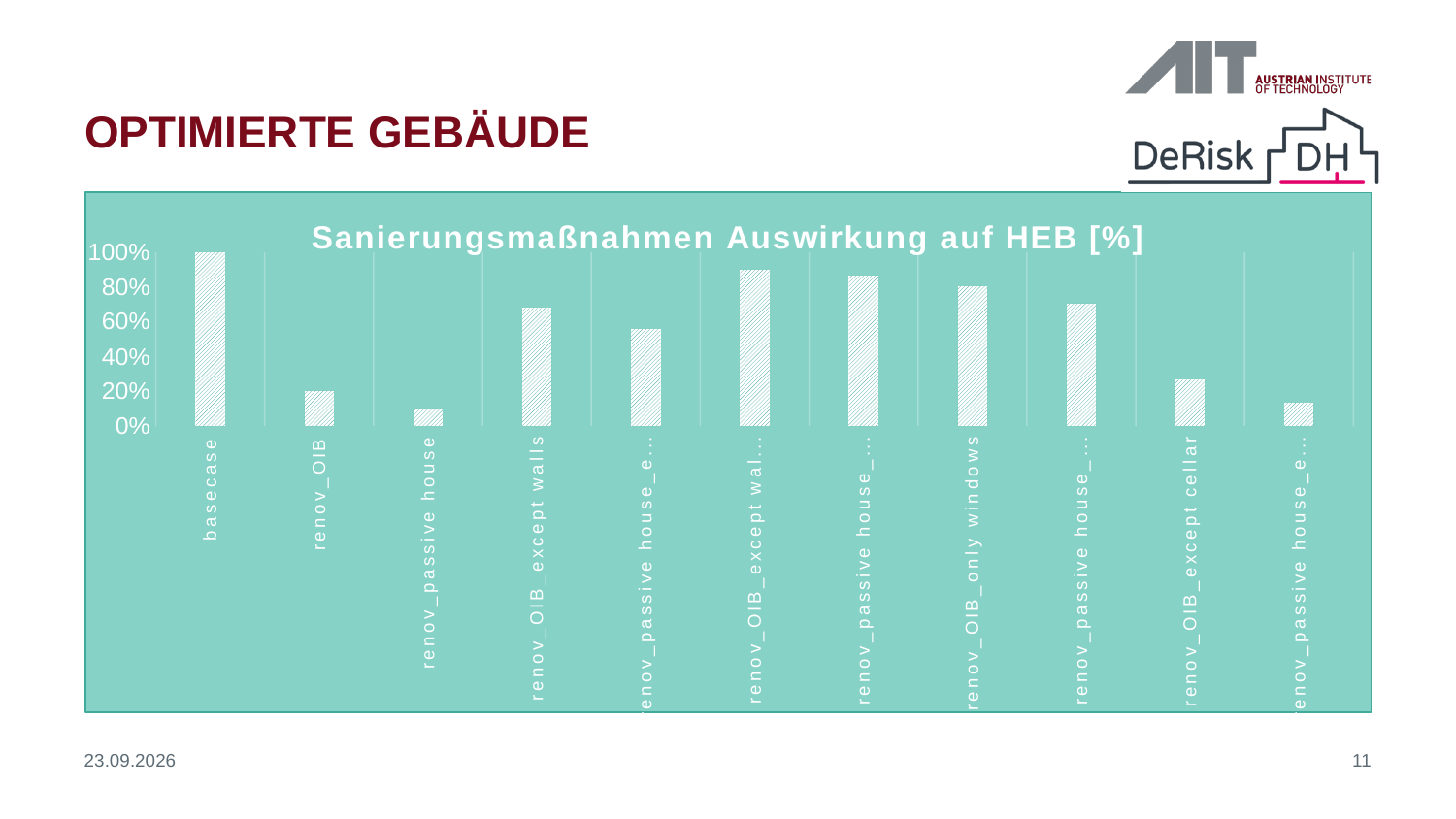
What kind of chart is shown on the slide? bar chart Which is larger, the value for renov_OIB_except walls or the value for renov_OIB_only windows? renov_OIB_only windows What is the value for basecase? 100% Is the value for renov_OIB_except walls greater or less than 60%? greater How many bars are plotted in the chart? 11 Which category has the highest value? basecase Which is larger, the value for renov_OIB or the value for renov_passive house? renov_OIB Is the value for renov_OIB greater or less than 40%? less Which category has the lowest value? renov_passive house Is the value for renov_OIB_only windows greater or less than 60%? greater What is the title of the chart? Sanierungsmaßnahmen Auswirkung auf HEB [%]